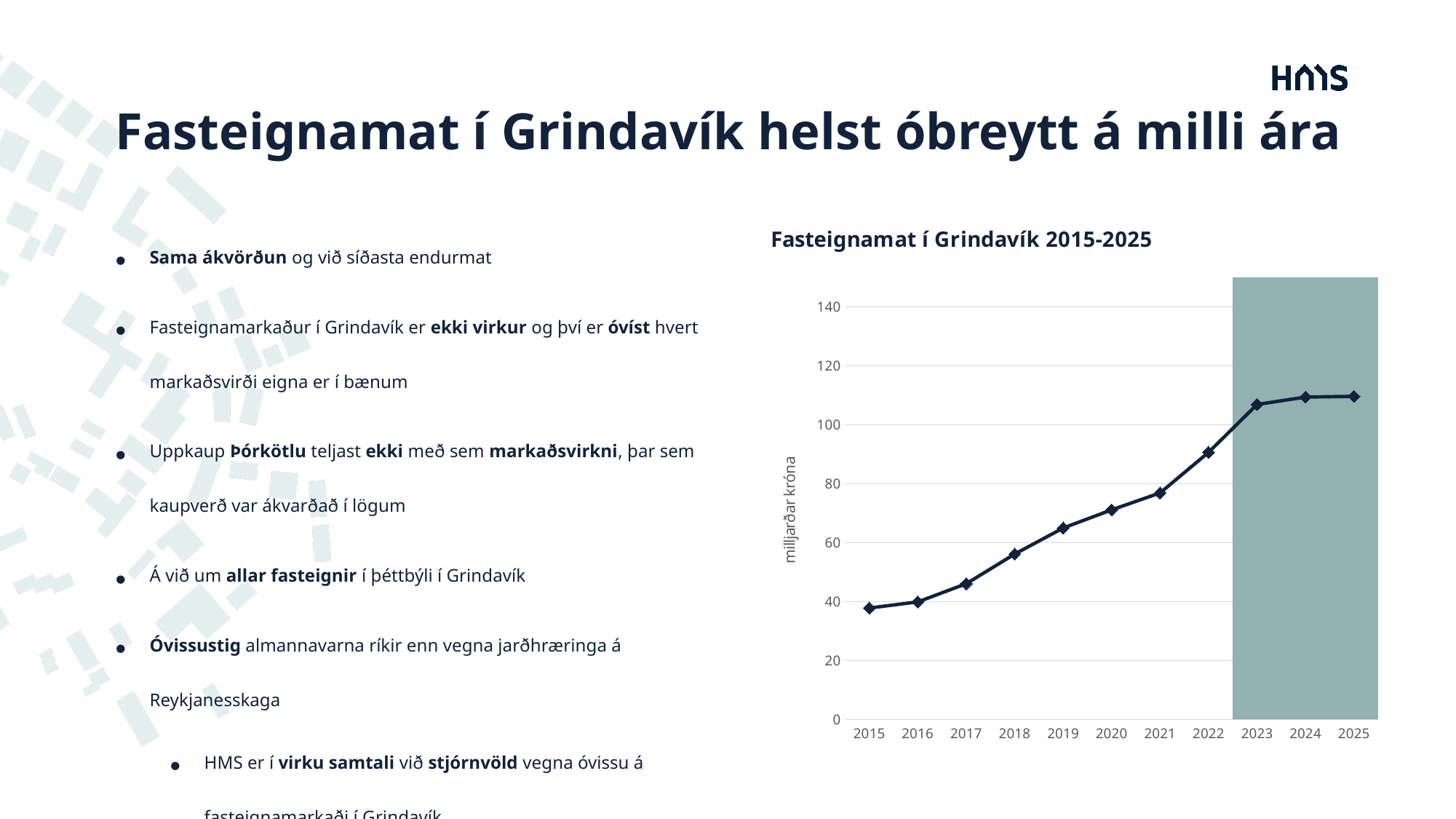
Is the value for 2022 greater or less than 80? greater Which year has the lowest value on the chart? 2015 How many years (data points) are plotted on the chart? 11 Which is larger, the value for 2019 or the value for 2022? 2022 What is the label on the vertical axis of the chart? milljarðar króna Is the value for 2020 greater or less than 60? greater What is the title of the chart? Fasteignamat í Grindavík 2015-2025 Is the value for 2015 greater or less than 60? less What kind of chart is shown on the slide? line chart Do the values generally rise or fall from 2015 to 2025? rise